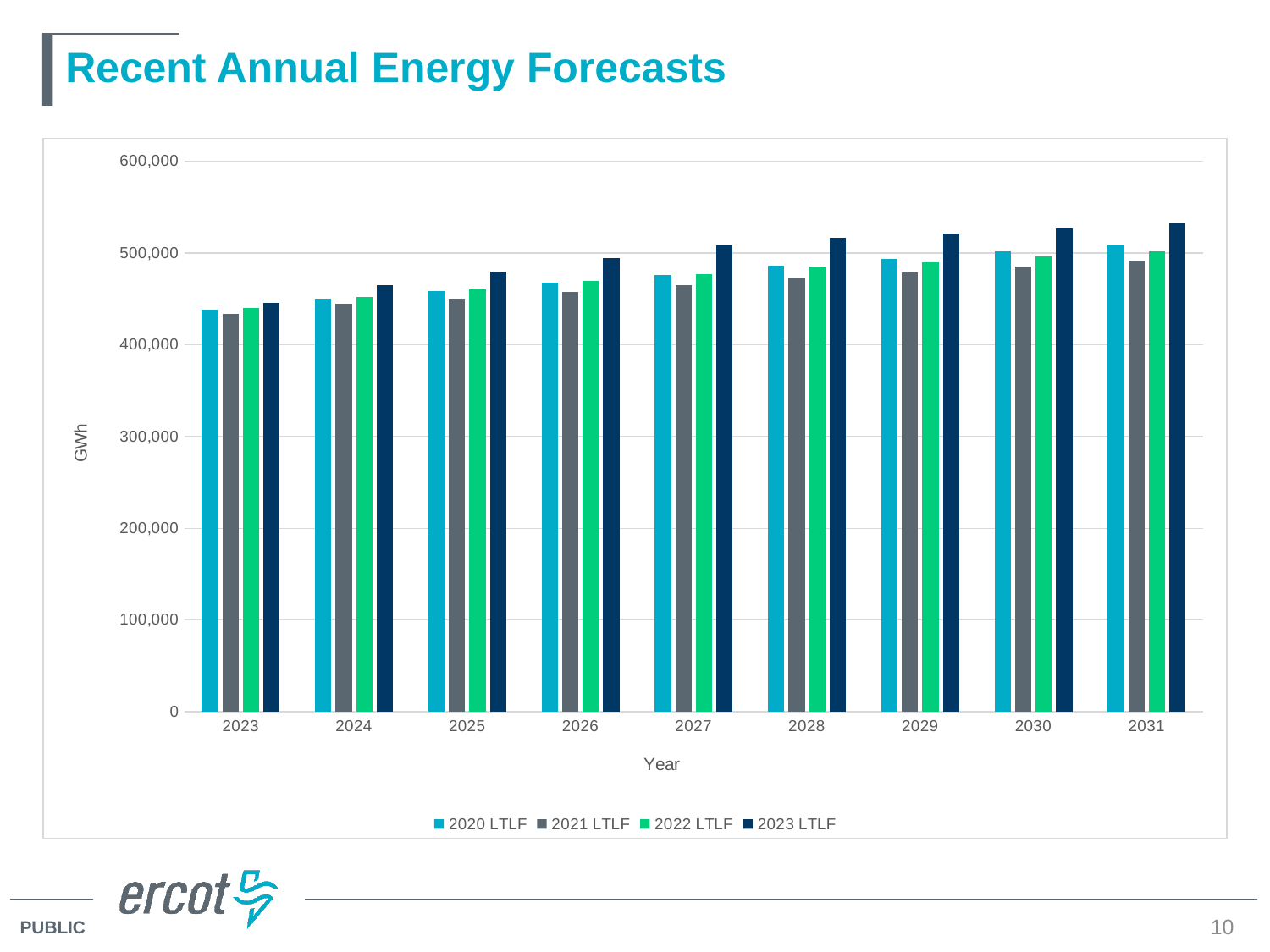
Is the 2021 LTLF value for 2023 greater or less than 500,000? less Is the 2023 LTLF value for 2030 greater or less than 500,000? greater In which year does the 2023 LTLF series reach its highest value? 2031 For 2031, which series has the highest value? 2023 LTLF Is the 2022 LTLF value for 2025 greater or less than 500,000? less How many years are shown on the x axis? 9 Do the 2023 LTLF values rise or fall from 2023 to 2031? rise What is the label on the vertical axis? GWh How many series does the legend list? 4 What kind of chart is shown on the slide? bar chart For 2031, which is larger: the 2023 LTLF value or the 2021 LTLF value? 2023 LTLF